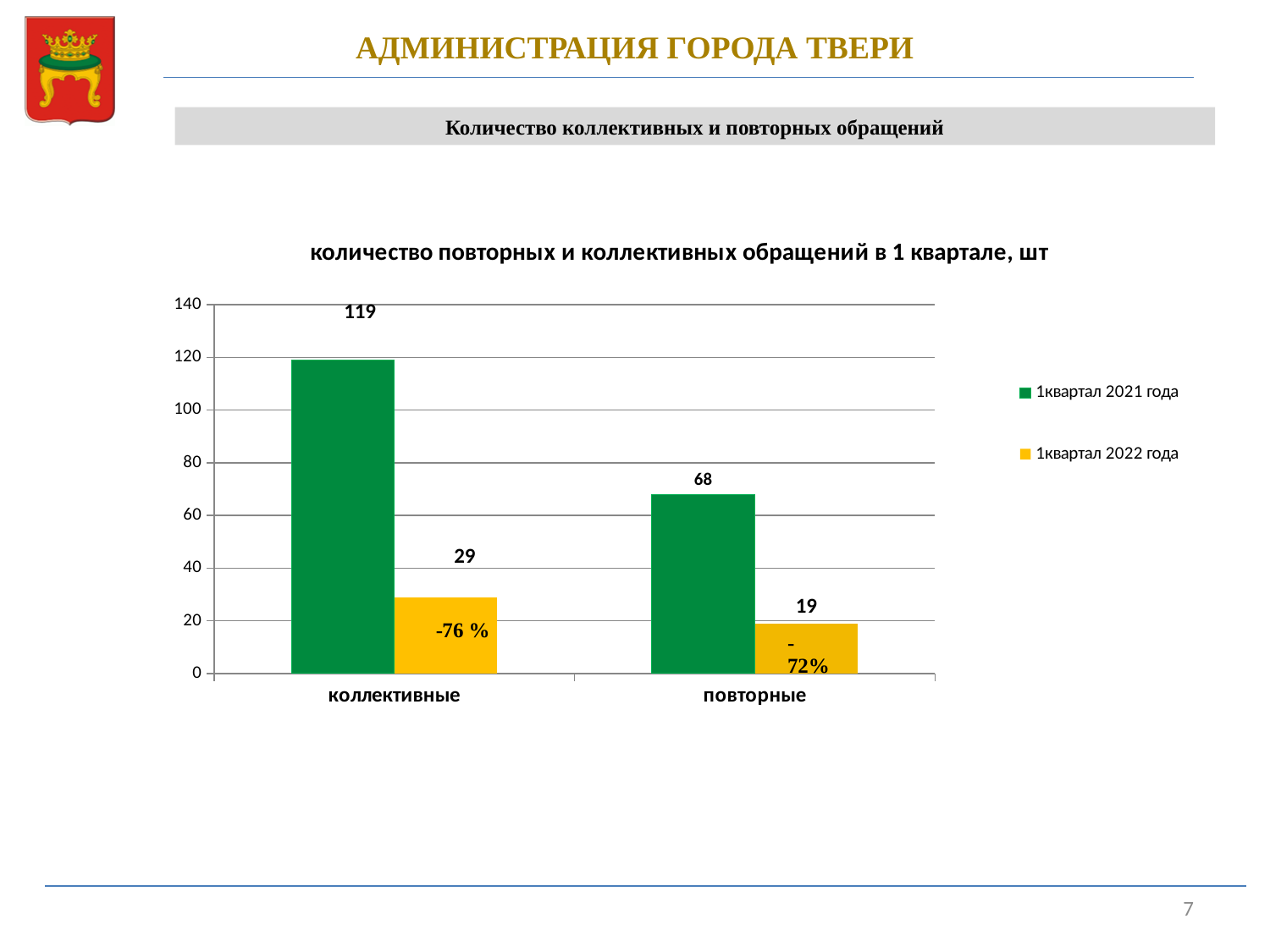
How many categories are shown on the x axis? 2 What kind of chart is shown on the slide? bar chart Which category has the highest value in 1квартал 2021 года? коллективные Which is larger: the 1квартал 2021 года value for повторные or the 1квартал 2022 года value for коллективные? 1квартал 2021 года value for повторные How many series does the legend list? 2 What is the value for повторные in 1квартал 2021 года? 68 What is the value for коллективные in 1квартал 2021 года? 119 Which category has the lowest value in 1квартал 2022 года? повторные What is the difference between the 1квартал 2021 года and 1квартал 2022 года values for коллективные? 90 What is the value for коллективные in 1квартал 2022 года? 29 What is the value for повторные in 1квартал 2022 года? 19 What percentage change is printed on the 1квартал 2022 года bar for коллективные? -76 %